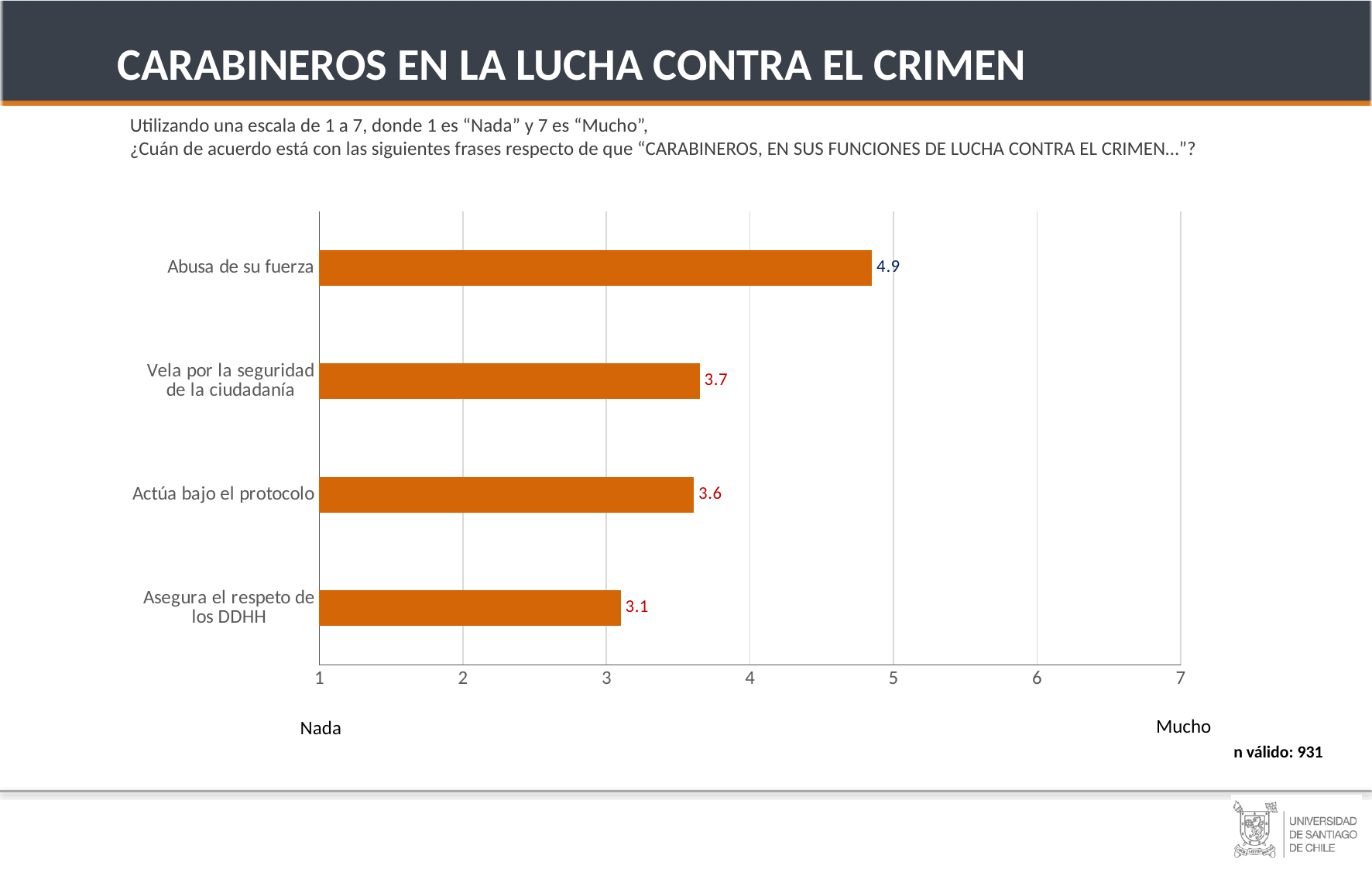
What kind of chart is shown on the slide? bar chart How many categories are shown in the chart? 4 What is the value for "Actúa bajo el protocolo"? 3.6 What is the value for "Vela por la seguridad de la ciudadanía"? 3.7 Which category has the highest value? Abusa de su fuerza Which category has the lowest value? Asegura el respeto de los DDHH Which is larger, the value for "Vela por la seguridad de la ciudadanía" or the value for "Asegura el respeto de los DDHH"? Vela por la seguridad de la ciudadanía What is the difference between the values for "Abusa de su fuerza" and "Asegura el respeto de los DDHH"? 1.8 What is the value for "Abusa de su fuerza"? 4.9 What is the value for "Asegura el respeto de los DDHH"? 3.1 What is the valid n (n válido) shown on the slide? 931 Is the value for "Abusa de su fuerza" greater or less than 4? greater